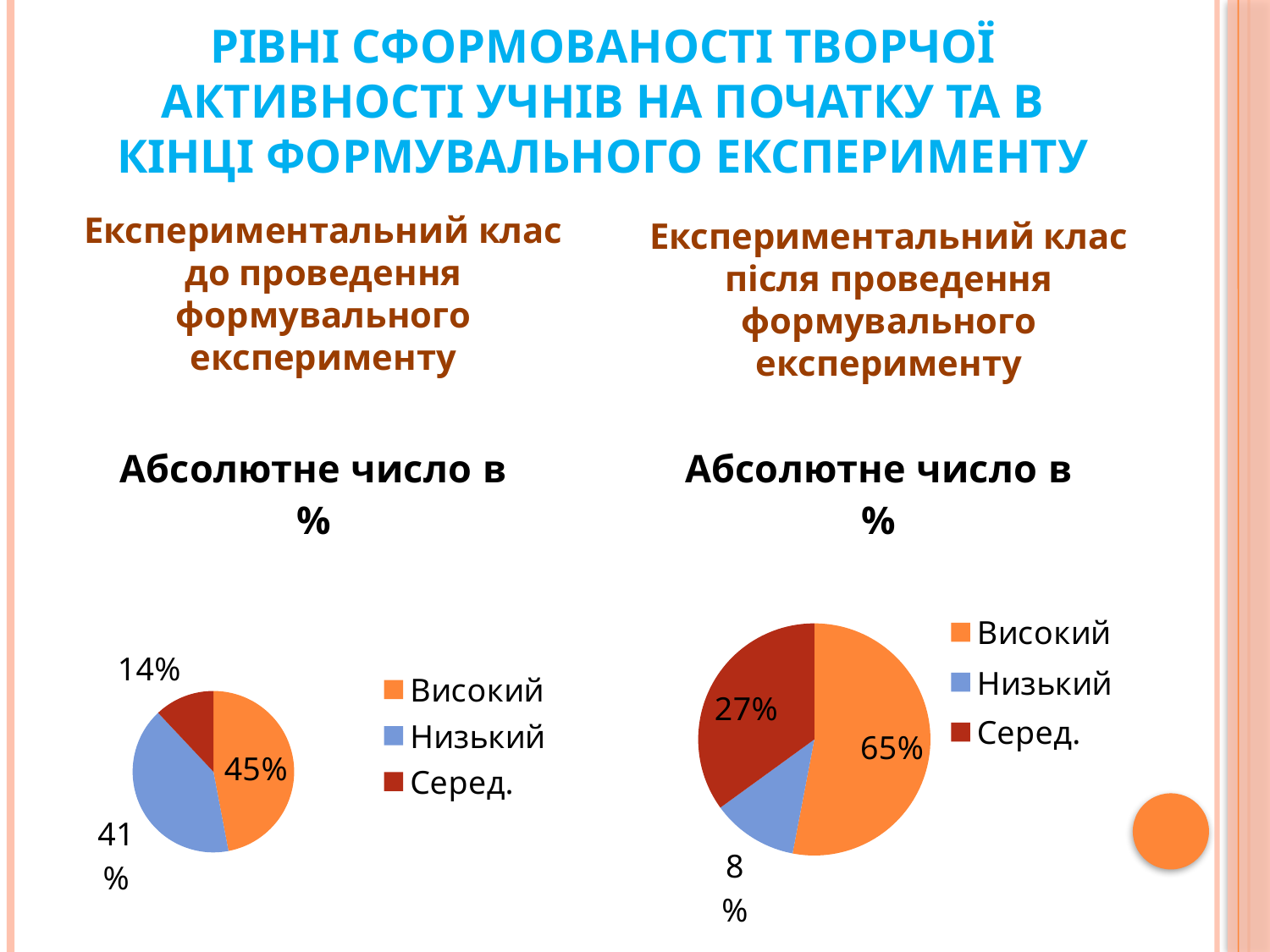
In the left pie chart (before the experiment), what is the value for Серед.? 14% In the right pie chart (after the experiment), which category has the largest share? Високий In the right pie chart (after the experiment), what is the value for Високий? 65% What type of chart is used on the right side of the slide? Pie chart In the right pie chart (after the experiment), what is the value for Низький? 8% In the left pie chart (before the experiment), which category has the smallest share? Серед. In the right pie chart (after the experiment), what is the value for Серед.? 27% In the right pie chart (after the experiment), which is larger: Серед. or Низький? Серед. In the left pie chart (before the experiment), what is the value for Високий? 45% How many categories does the legend of the left pie chart list? 3 In the left pie chart (before the experiment), what is the value for Низький? 41% What is the difference between the Високий value in the right pie chart and the Високий value in the left pie chart? 20%